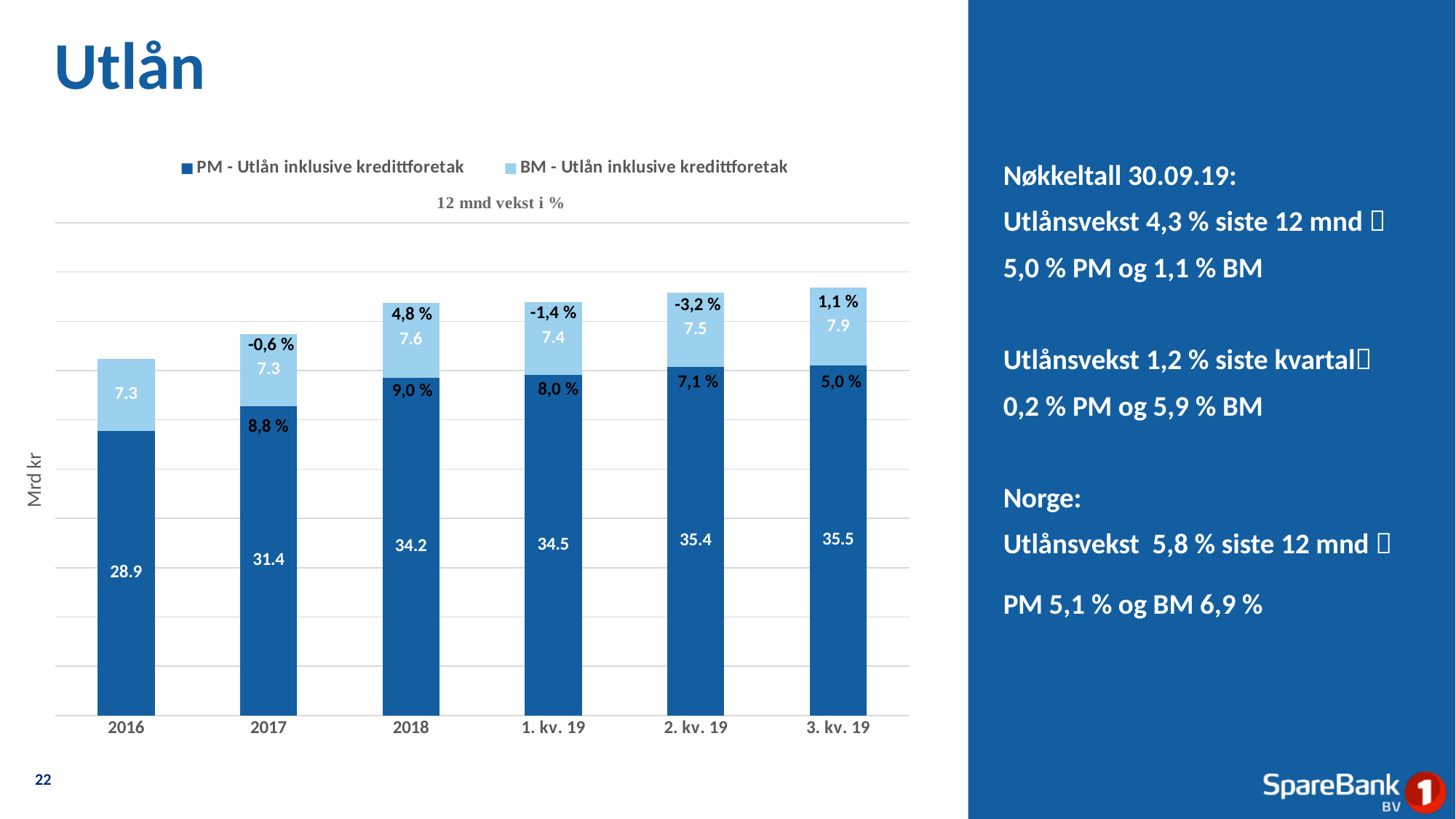
Is the BM value larger in 2018 or in 1. kv. 19? 2018 Which category has the lowest PM - Utlån inklusive kredittforetak value? 2016 What is the total of the stacked bar for 3. kv. 19? 43.4 What is the BM - Utlån inklusive kredittforetak value for 3. kv. 19? 7.9 What is the difference between the PM values for 3. kv. 19 and 2016? 6.6 What 12-month growth percentage is shown for the PM segment in 2018? 9,0 % What kind of chart is shown on the slide? Stacked bar chart How many series does the legend list? 2 Which category has the highest PM - Utlån inklusive kredittforetak value? 3. kv. 19 What 12-month growth percentage is shown for the BM segment in 2. kv. 19? -3,2 % How many categories are shown on the x axis? 6 What is the PM - Utlån inklusive kredittforetak value for 2016? 28.9